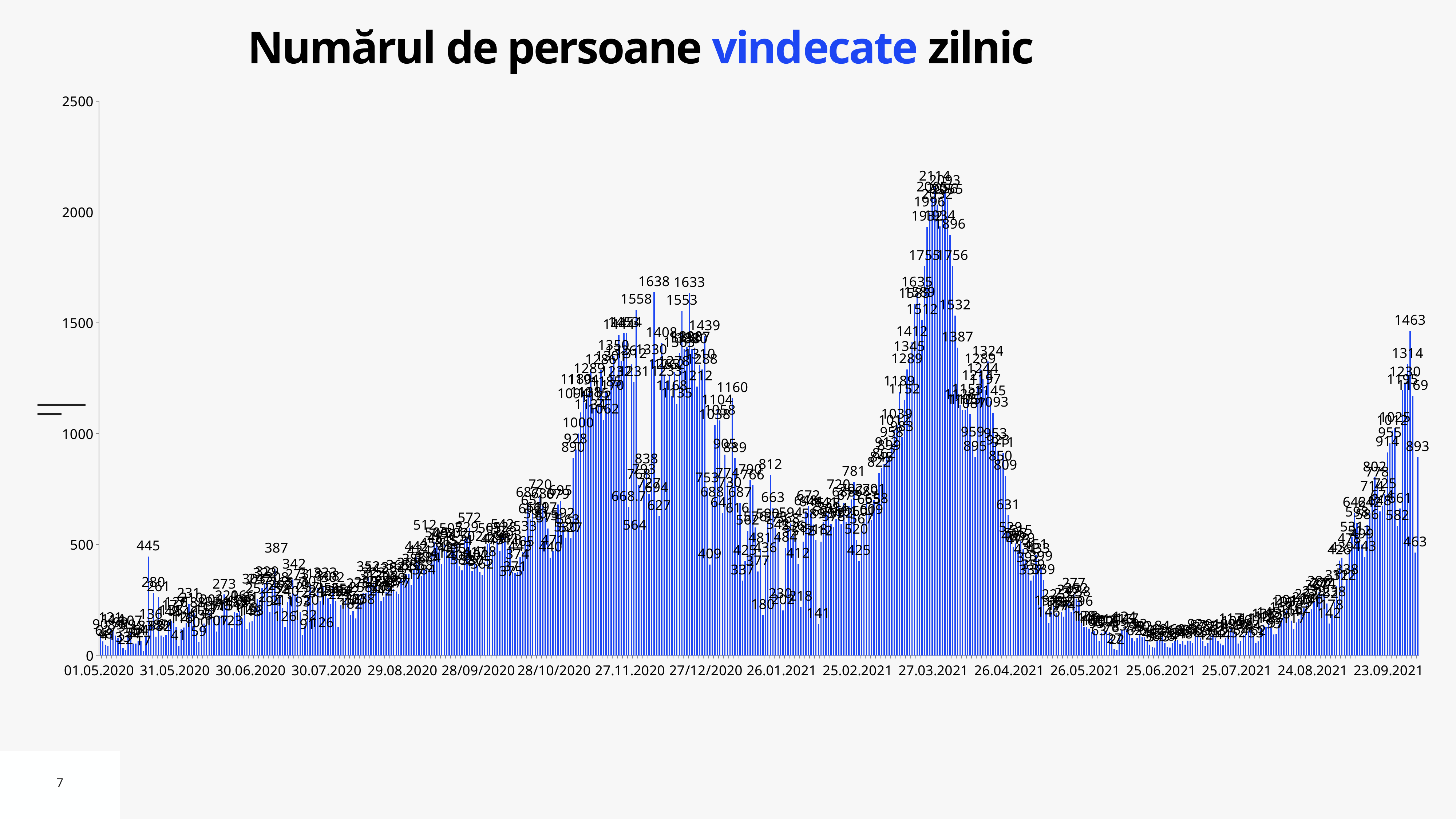
Are the bars around 25.06.2021 greater or less than 500? less Which peak is higher: the one around 27.03.2021 or the one around 27.11.2020? the one around 27.03.2021 What is the highest data label shown in the peak around 27.11.2020? 1638 Do the values rise or fall between 26.04.2021 and 25.06.2021? fall How many date labels are shown on the x axis? 18 What kind of chart is shown on the slide? bar chart What is the highest data label shown in the final rise near 23.09.2021? 1463 What is the value of the isolated spike labelled shortly before 31.05.2020? 445 Is the tallest bar around 27.03.2021 greater or less than 2000? greater What is the highest data label shown on the chart? 2114 What is the difference between the highest label of the peak around 27.03.2021 (2114) and the highest label of the peak around 27.11.2020 (1638)? 476 What is the title of the chart? Numărul de persoane vindecate zilnic